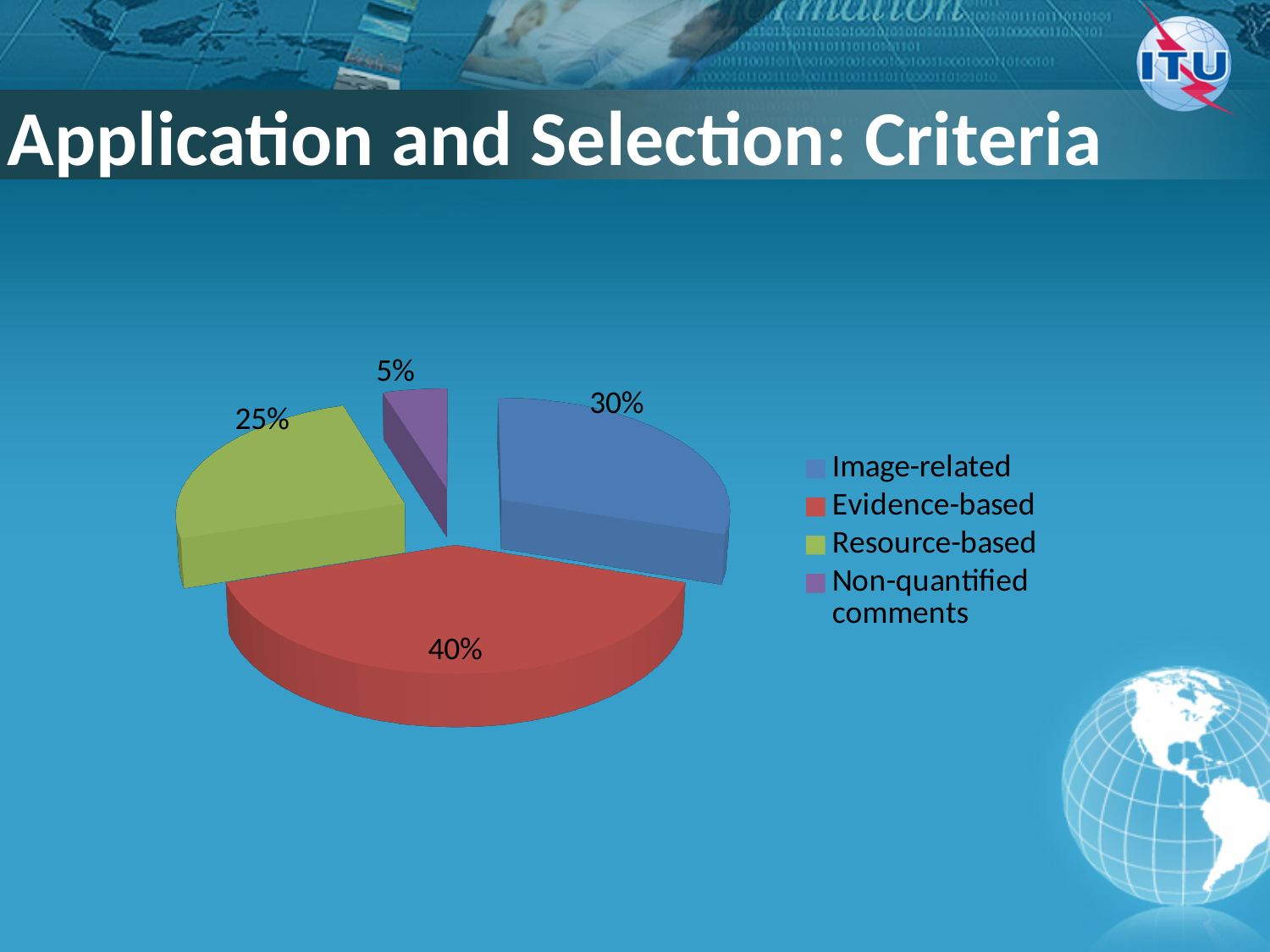
Which is larger, the Image-related share or the Resource-based share? Image-related Which category has the largest slice of the pie? Evidence-based Which category has the smallest slice of the pie? Non-quantified comments What is the difference between the Evidence-based and Image-related shares? 10% What is the difference between the Resource-based and Non-quantified comments shares? 20% What share of the pie is Resource-based? 25% How many categories does the pie chart have? 4 What colour is the Resource-based slice? green What share of the pie is Image-related? 30% What kind of chart is shown on the slide? pie chart What share of the pie is Non-quantified comments? 5%